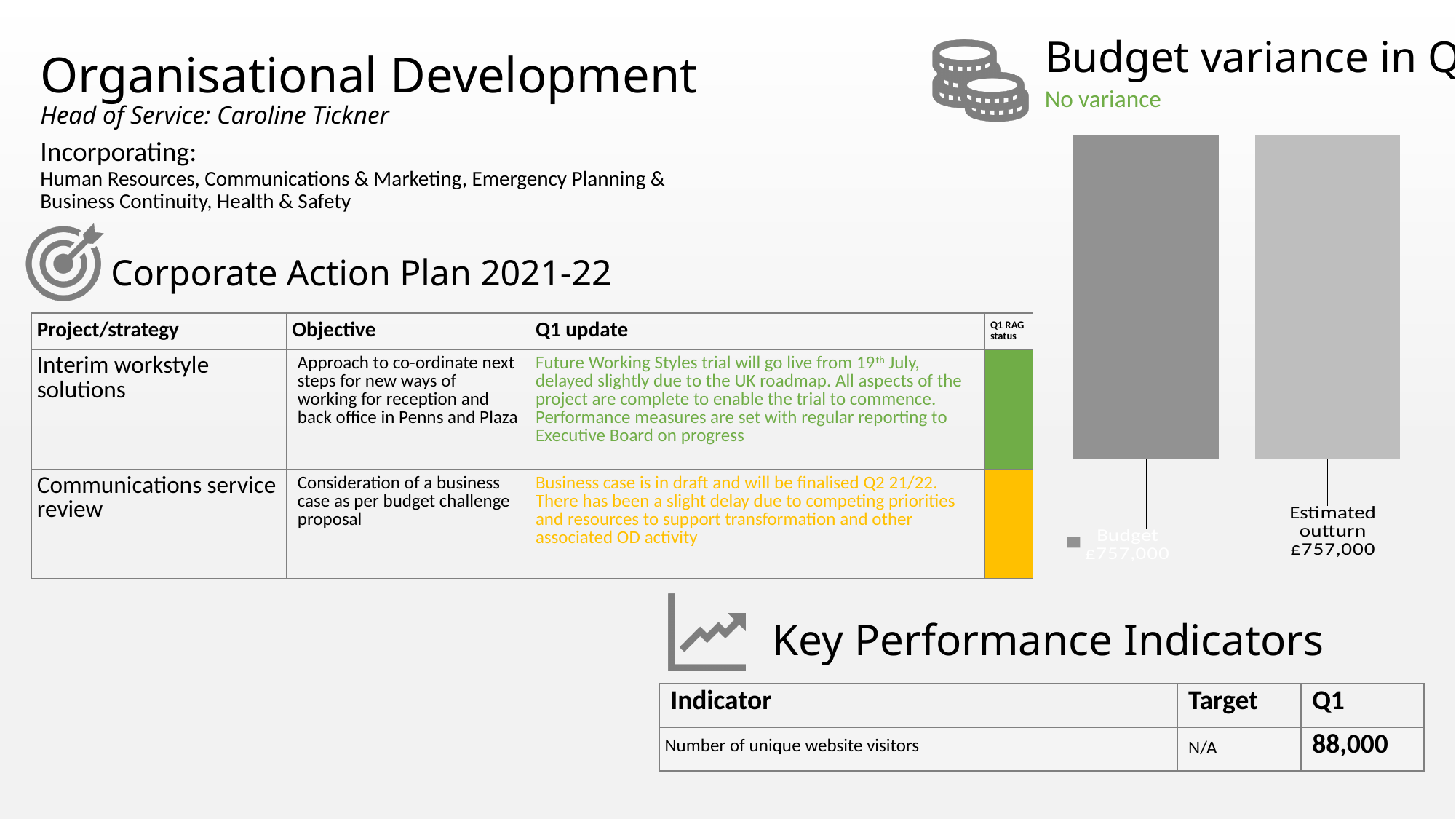
How many bars does the budget variance chart show? 2 What is the difference between the Budget and Estimated outturn values in the budget variance chart? £0 What are the two categories shown in the budget variance chart? Budget and Estimated outturn What kind of chart is shown under the Budget variance heading? bar chart What is the value of the Estimated outturn bar in the budget variance chart? £757,000 What is the value of the Budget bar in the budget variance chart? £757,000 What does the text under the Budget variance heading say about the variance? No variance